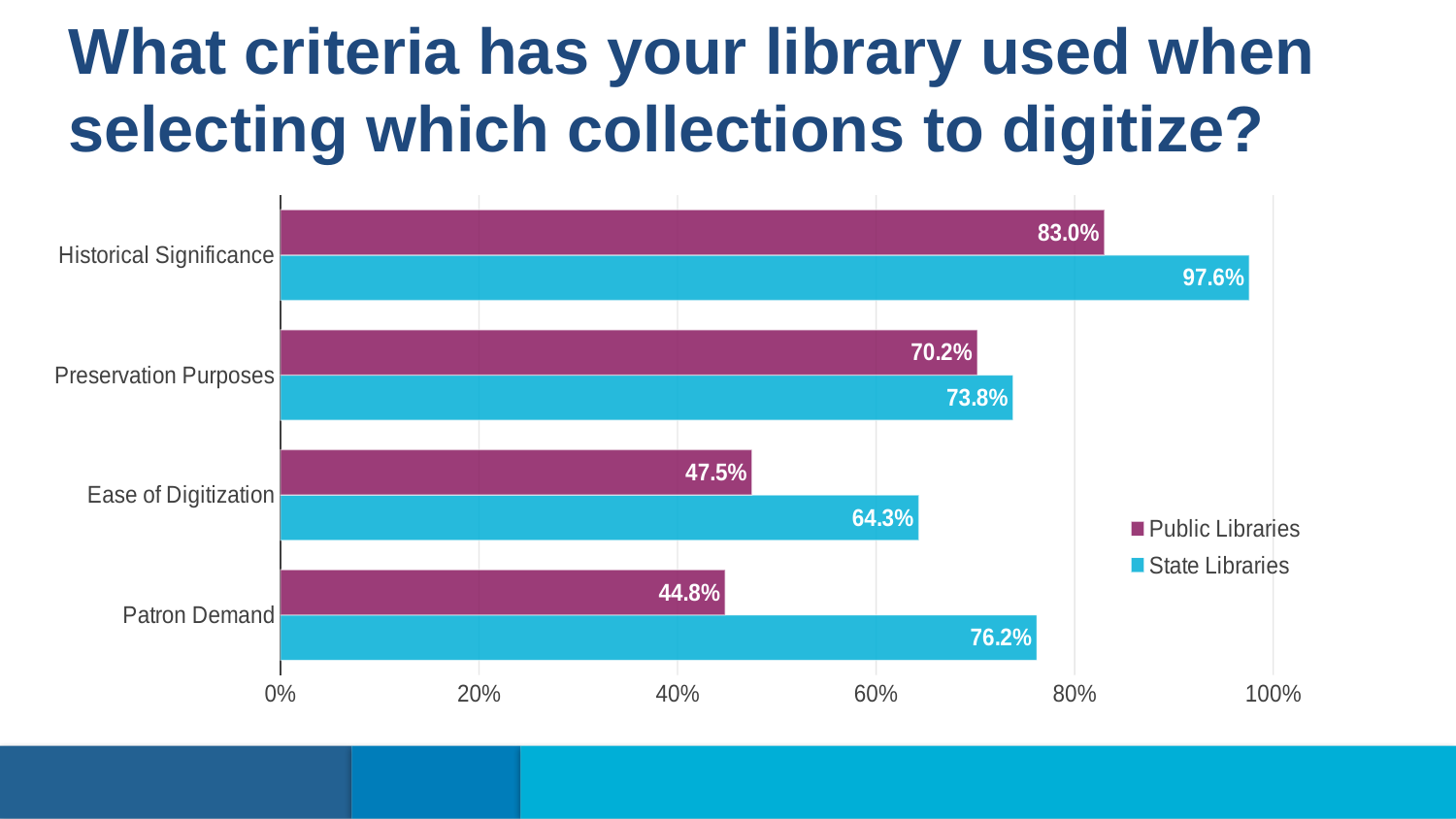
Which criterion has the highest value for State Libraries? Historical Significance Which criterion has the lowest value for Public Libraries? Patron Demand What is the value for Public Libraries for Ease of Digitization? 47.5% What is the difference between State Libraries and Public Libraries for Patron Demand? 31.4% Which is larger for Ease of Digitization: Public Libraries or State Libraries? State Libraries How many series does the legend list? 2 What is the difference between State Libraries and Public Libraries for Historical Significance? 14.6% What percentage of State Libraries cited Historical Significance as a criterion? 97.6% How many criteria are shown on the chart? 4 What percentage of Public Libraries cited Patron Demand as a criterion? 44.8% Which colour represents Public Libraries in the chart? Purple What kind of chart is shown on the slide? Bar chart